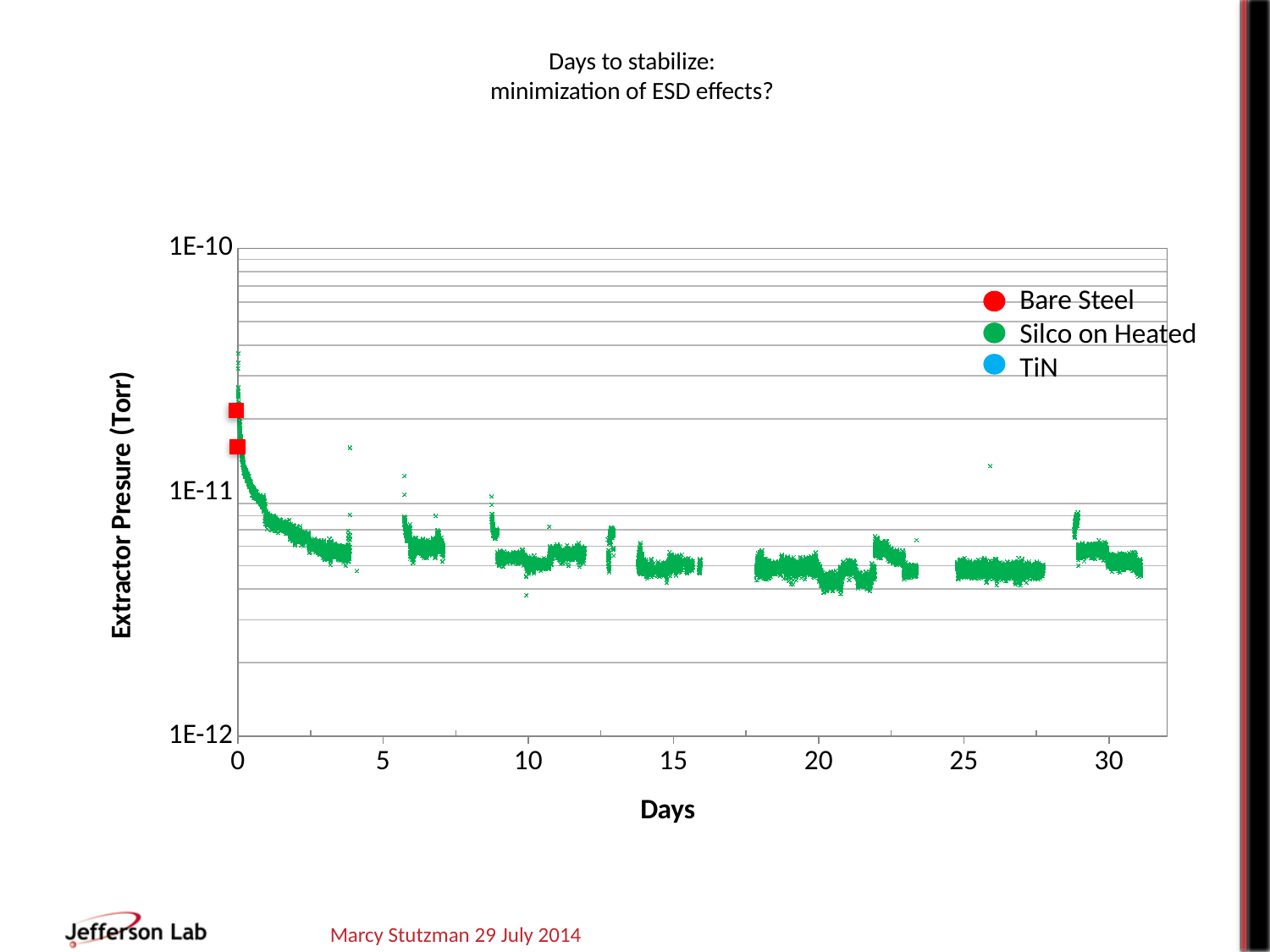
Is the Bare Steel value at day 0 greater or less than 1E-11? greater Is the Silco on Heated value at day 10 greater or less than 1E-11? less Is the Silco on Heated value at day 30 greater or less than 1E-11? less How many series does the legend list? 3 Do the Silco on Heated values rise or fall as the days increase from 0 to 5? fall What is the label of the y axis? Extractor Presure (Torr) Which series is plotted in green? Silco on Heated What is the title of the chart? Days to stabilize: minimization of ESD effects? What kind of chart is shown on the slide? Scatter chart